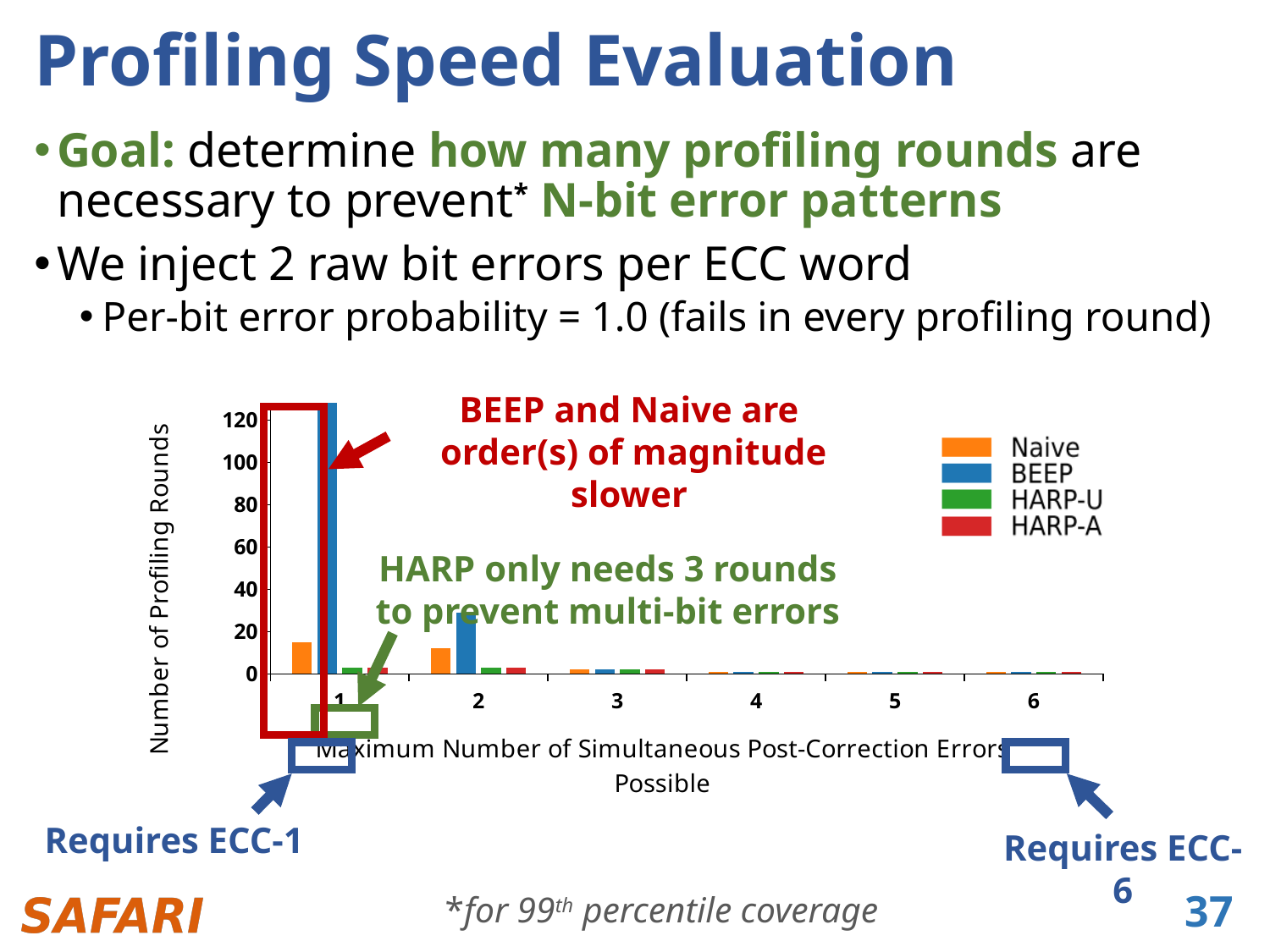
Do the BEEP values rise or fall as the x-axis value increases from 1 to 6? fall Is the Naive value at x = 1 greater or less than 20? less Is the BEEP value at x = 2 greater or less than 20? greater At x = 2, which is larger: the Naive value or the HARP-U value? Naive What kind of chart is shown on the slide? bar chart Which series has the tallest bar at x = 1? BEEP Is the BEEP value at x = 2 greater or less than 40? less How many categories are shown along the x axis of the chart? 6 What is the label of the y axis of the chart? Number of Profiling Rounds How many series does the chart legend list? 4 At x = 1, which is larger: the Naive value or the BEEP value? BEEP